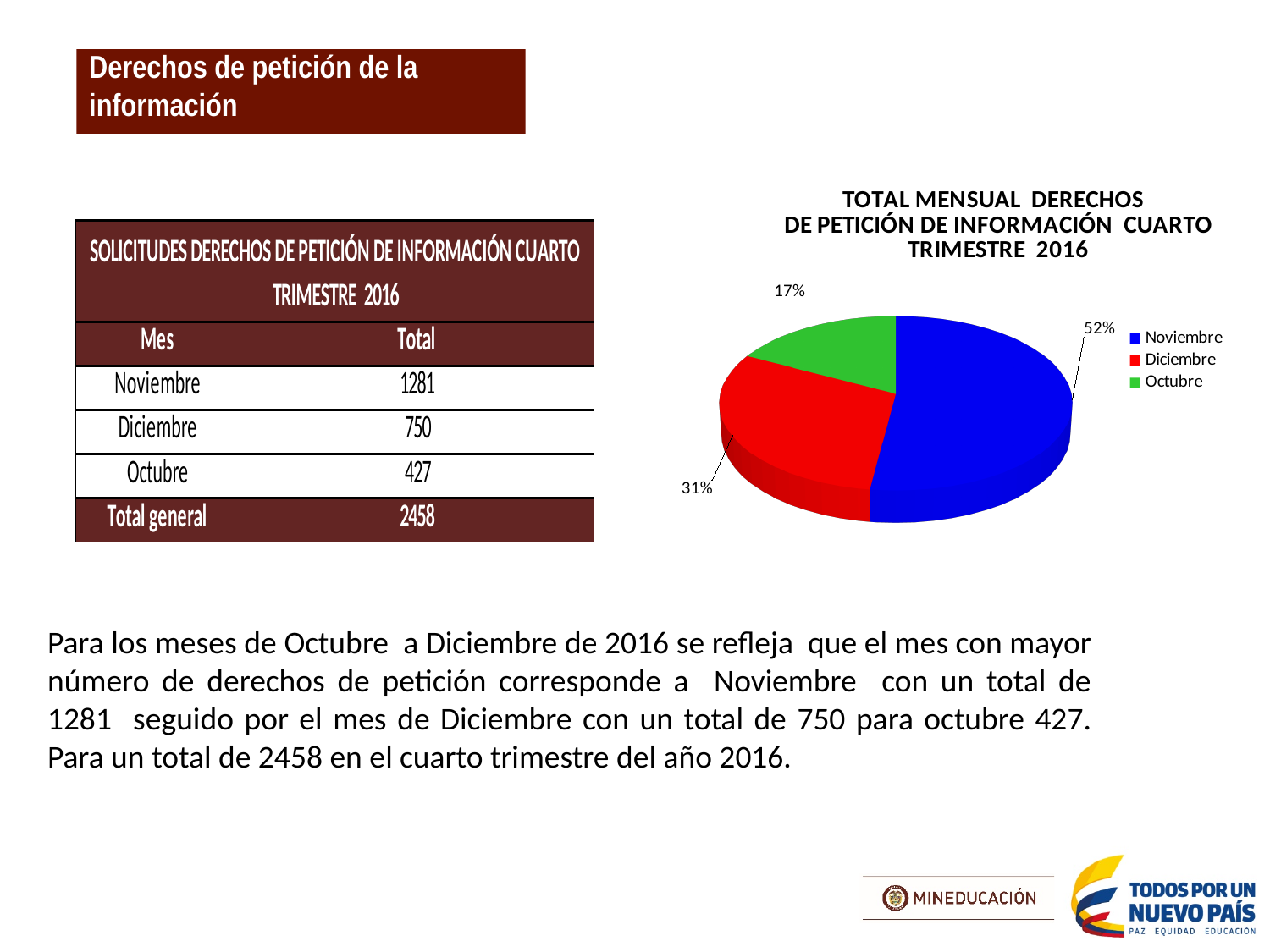
What share of the pie chart does Noviembre represent? 52% What share of the pie chart does Diciembre represent? 31% What colour is the Octubre slice in the pie chart? green How many slices does the pie chart have? 3 What is the difference in percentage points between the Noviembre and Diciembre slices of the pie chart? 21% What kind of chart is shown on the slide? pie chart What is the title of the pie chart? TOTAL MENSUAL DERECHOS DE PETICIÓN DE INFORMACIÓN CUARTO TRIMESTRE 2016 How many entries does the legend of the pie chart list? 3 In the pie chart, which slice is larger, Diciembre or Octubre? Diciembre What share of the pie chart does Octubre represent? 17% Which month has the largest slice in the pie chart? Noviembre Which month has the smallest slice in the pie chart? Octubre